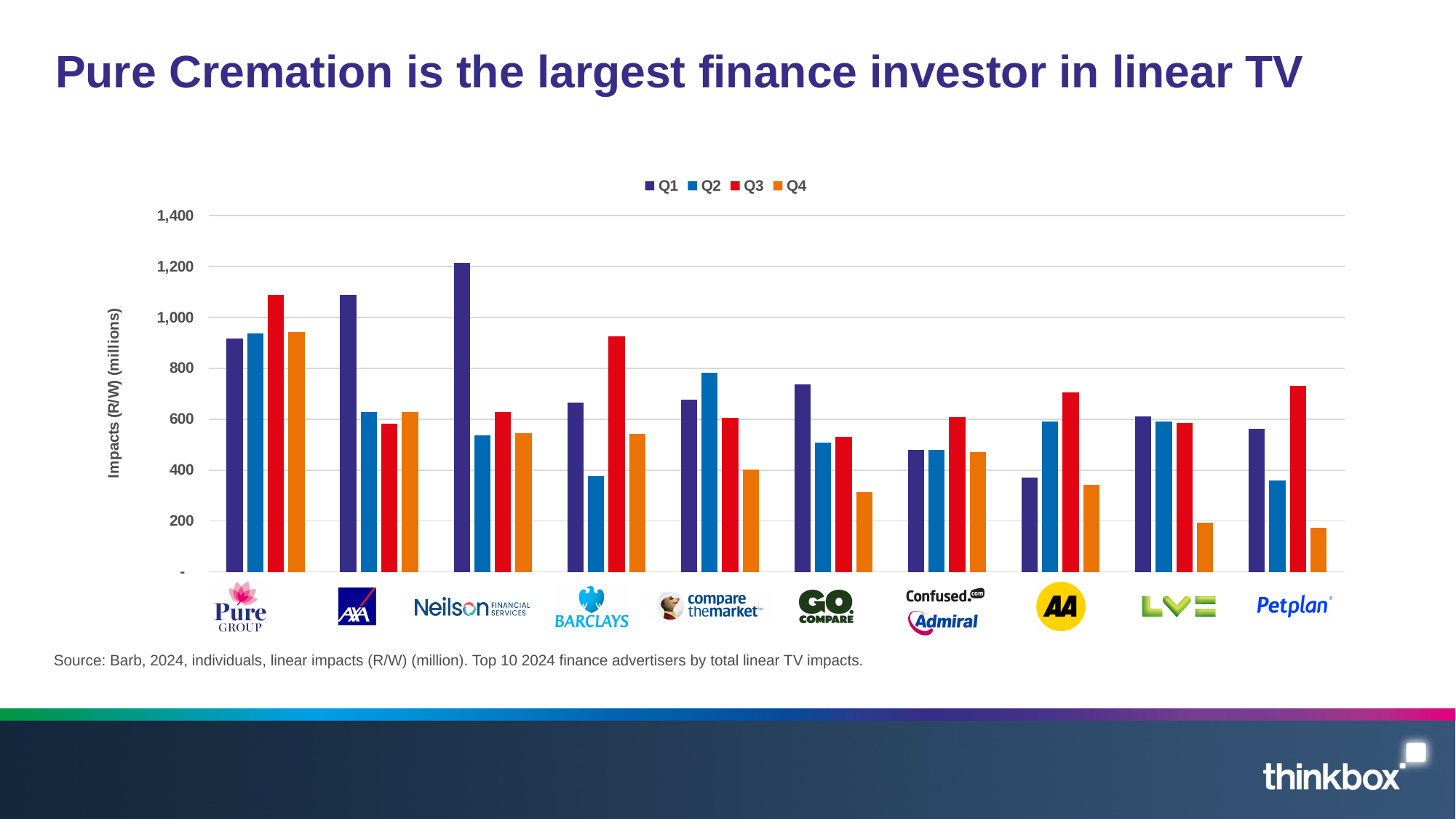
How many series does the legend list? 4 Which advertiser has the highest Q1 bar? Neilson Financial Services How many advertisers (categories) are shown on the x axis? 10 Is the Q4 value for Petplan greater or less than 200? less Which advertiser has the highest Q3 bar? Pure Group For AXA, which is larger: the Q1 value or the Q2 value? Q1 For Barclays, which is larger: the Q1 value or the Q3 value? Q3 Is the Q1 value for Neilson Financial Services greater or less than 1,000? greater Is the Q2 value for Barclays greater or less than 400? less What is the label on the y axis? Impacts (R/W) (millions) Which advertiser has the lowest Q1 bar? AA What kind of chart is shown on the slide? Bar chart